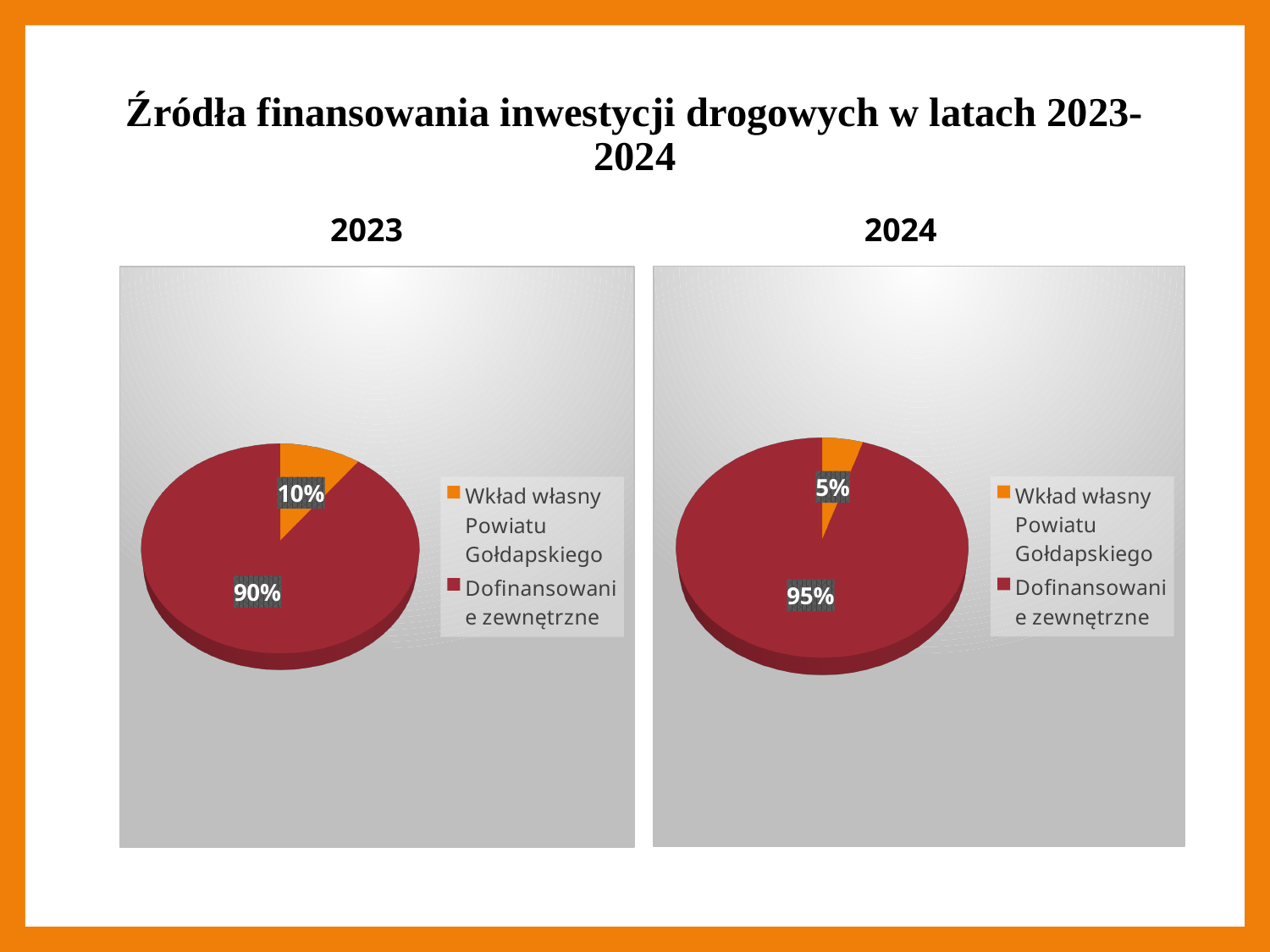
In the 2024 chart, what colour is the Wkład własny Powiatu Gołdapskiego slice? Orange In the 2023 chart, what share does Wkład własny Powiatu Gołdapskiego have? 10% How many series does the legend of the 2023 chart list? 2 What kind of chart is the 2023 chart? Pie chart In the 2024 chart, what share does Wkład własny Powiatu Gołdapskiego have? 5% How many slices does the 2024 chart have? 2 In the 2023 chart, what share does Dofinansowanie zewnętrzne have? 90% Is the Wkład własny Powiatu Gołdapskiego share larger in the 2023 chart or the 2024 chart? 2023 In the 2023 chart, which slice is the largest? Dofinansowanie zewnętrzne In the 2023 chart, what is the difference between the Dofinansowanie zewnętrzne share and the Wkład własny Powiatu Gołdapskiego share? 80% In the 2024 chart, which slice is the smallest? Wkład własny Powiatu Gołdapskiego In the 2024 chart, what share does Dofinansowanie zewnętrzne have? 95%